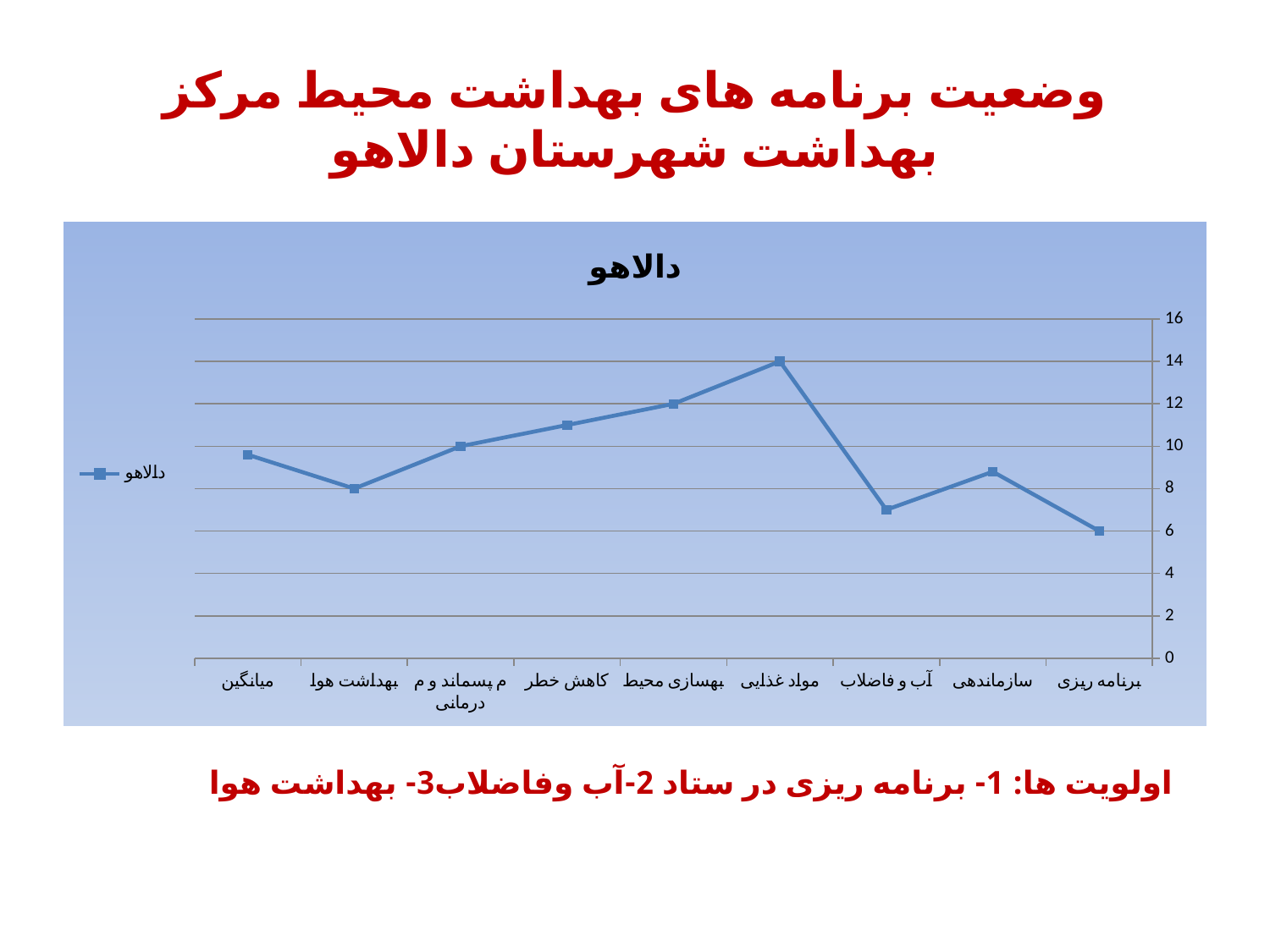
How many series does the legend list? 1 What is the title of the chart? دالاهو What is the difference between the values for مواد غذایی and برنامه ریزی? 8 What is the value for برنامه ریزی? 6 What type of chart is shown on the slide? line chart What is the value for مواد غذایی? 14 Which is larger, the value for بهسازی محیط or the value for سازماندهی? بهسازی محیط How many categories are shown on the x axis? 9 Which category has the lowest value? برنامه ریزی What is the value for بهداشت هوا? 8 Is the value for آب و فاضلاب greater or less than 8? less Which category has the highest value? مواد غذایی